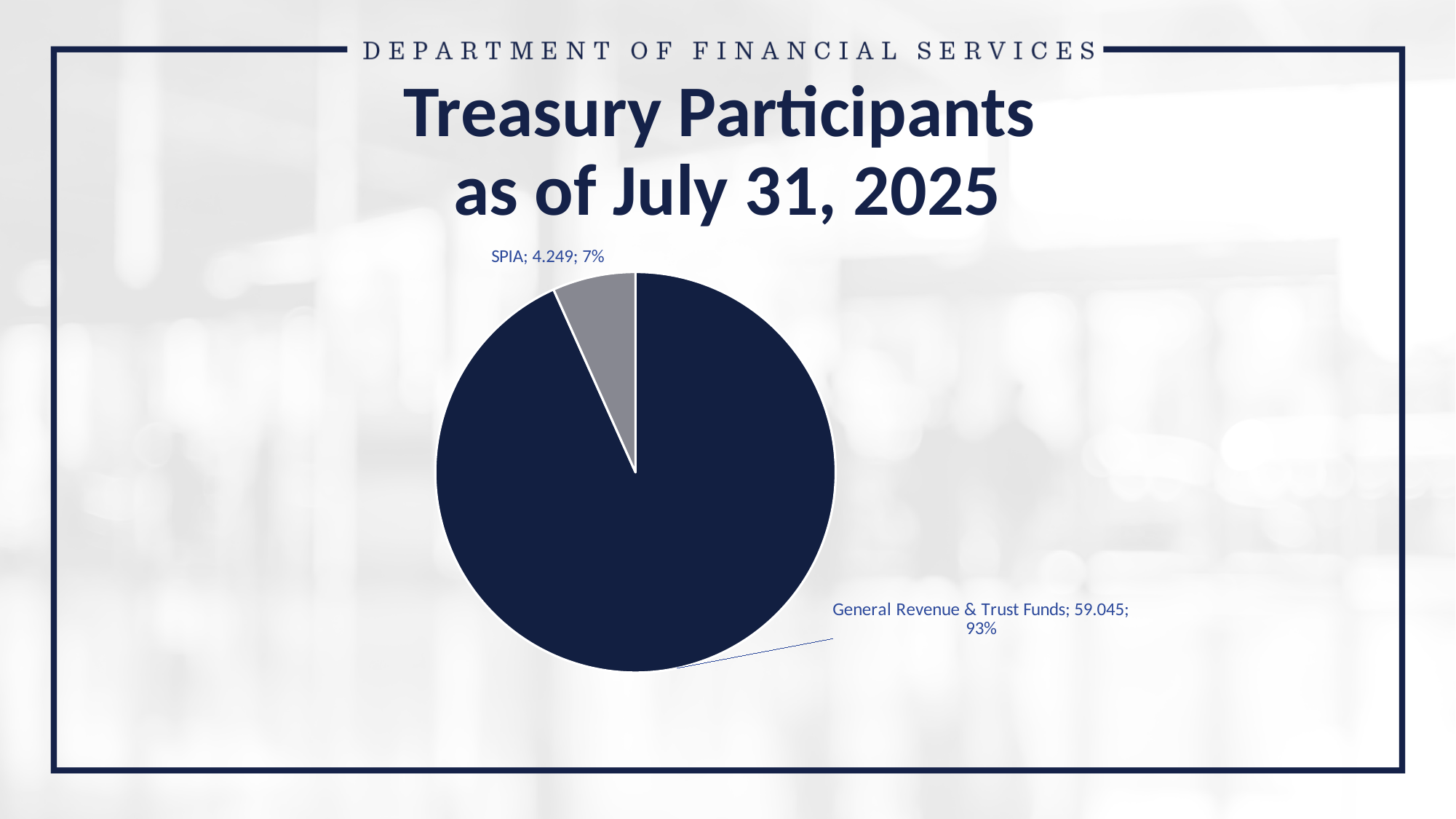
What is the value shown for General Revenue & Trust Funds? 59.045 What kind of chart is shown on the slide? Pie chart How many categories are shown in the pie chart? 2 What share of the pie does General Revenue & Trust Funds represent? 93% Which category has the largest slice of the pie? General Revenue & Trust Funds Which is larger, the value for SPIA or the value for General Revenue & Trust Funds? General Revenue & Trust Funds What is the difference between the values for General Revenue & Trust Funds and SPIA? 54.796 What is the title of the chart on the slide? Treasury Participants as of July 31, 2025 What is the value shown for SPIA? 4.249 What colour is the SPIA slice of the pie? Grey What share of the pie does SPIA represent? 7% Which category has the smallest slice of the pie? SPIA